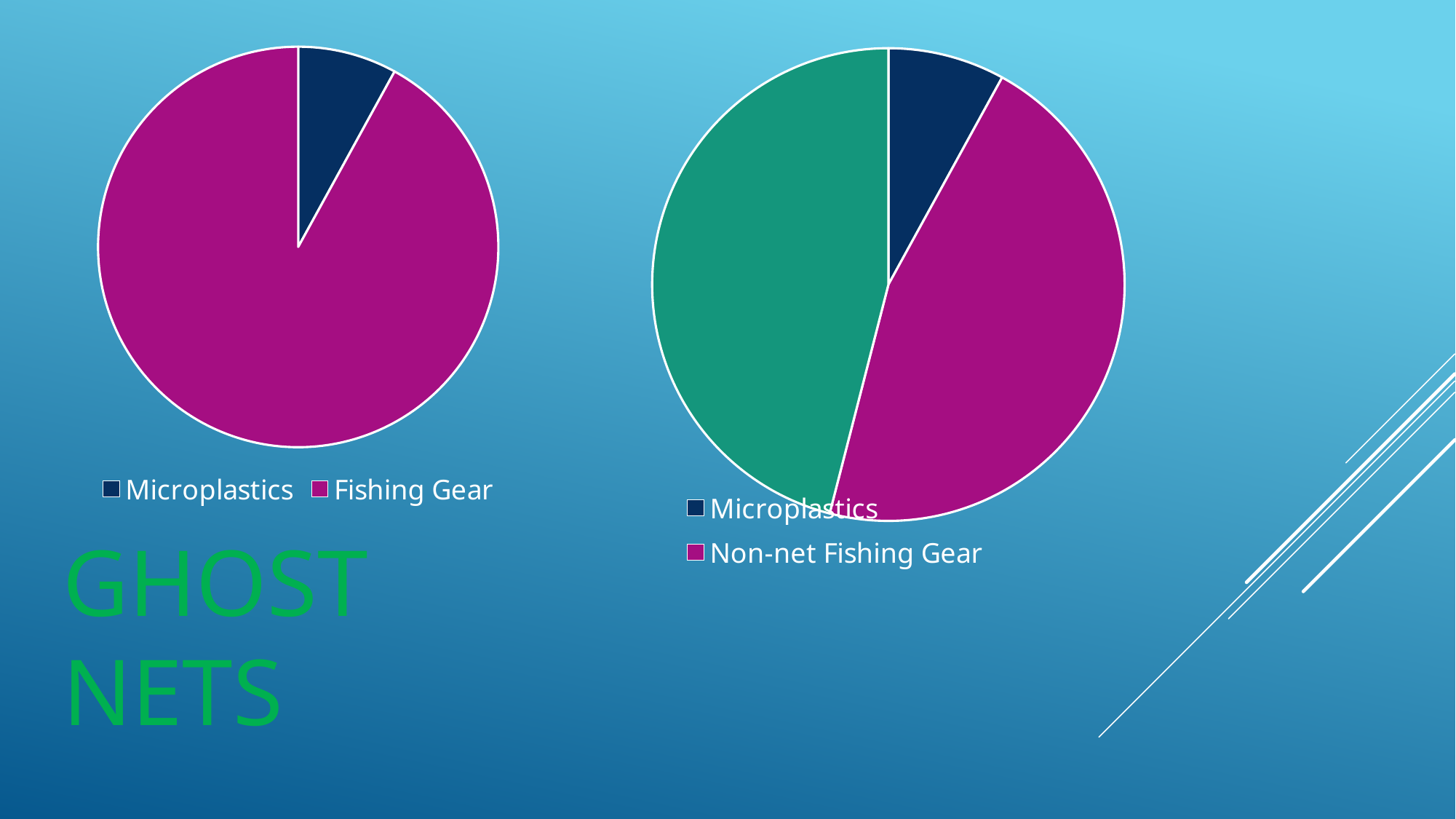
In the left pie chart, which slice is larger: Microplastics or Fishing Gear? Fishing Gear In the right pie chart, which of the legend categories has the smallest slice? Microplastics What kind of chart is the chart on the left of the slide? Pie chart How many slices does the left pie chart have? 2 In the right pie chart, which slice is larger: Microplastics or Non-net Fishing Gear? Non-net Fishing Gear In the left pie chart, what colour is the Microplastics slice? Dark blue In the left pie chart, which category has the smallest slice? Microplastics In the left pie chart, which category has the largest slice? Fishing Gear How many entries does the legend of the right pie chart list? 2 How many entries does the legend of the left pie chart list? 2 What kind of chart is the chart on the right of the slide? Pie chart How many slices does the right pie chart have? 3